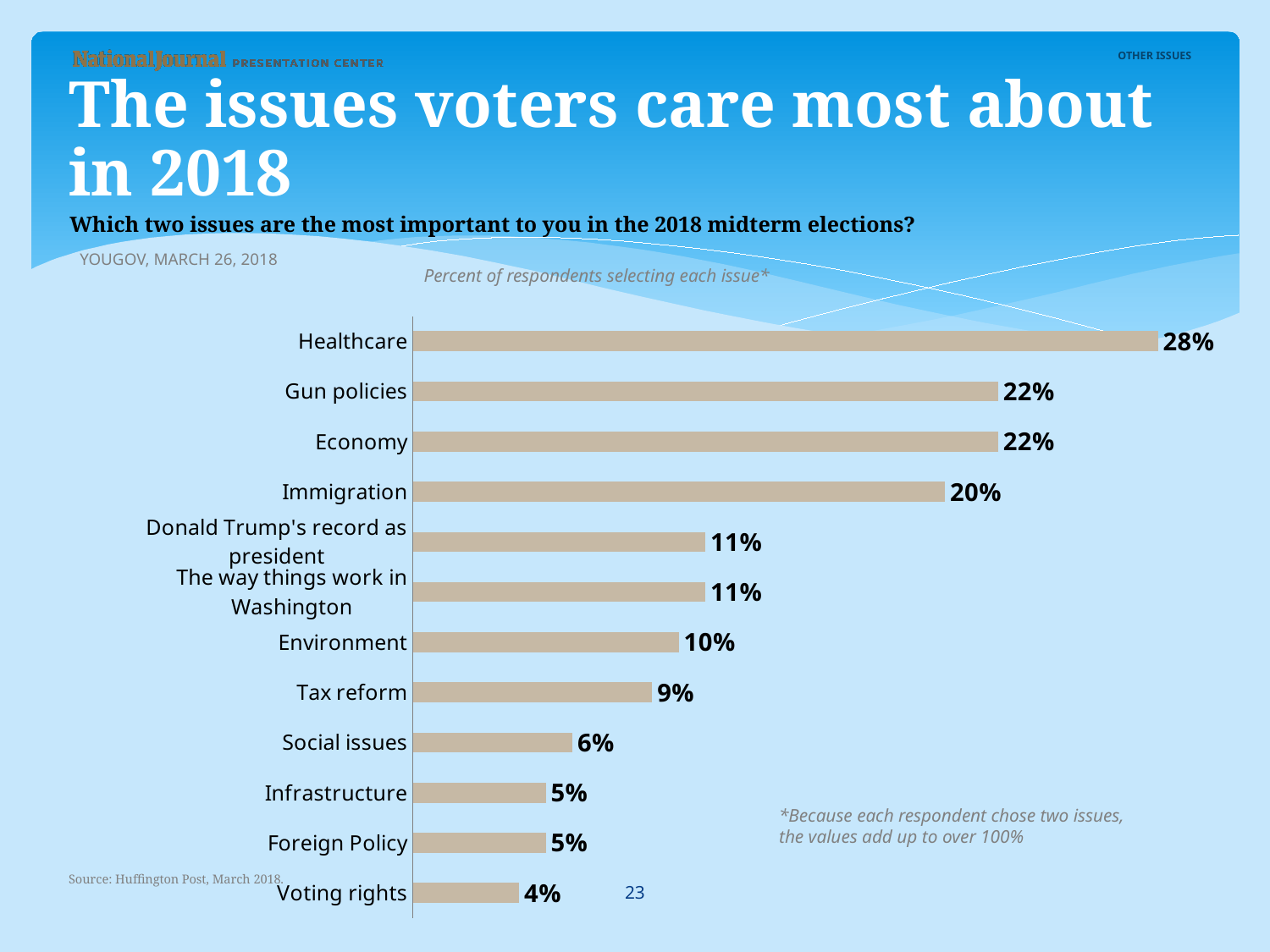
What percent of respondents selected Healthcare? 28% What kind of chart is shown on the slide? Bar chart What is the difference in percentage points between Immigration and Tax reform? 11 Which issue was selected by the lowest percent of respondents? Voting rights What percent of respondents selected Voting rights? 4% Which issue was selected by the highest percent of respondents? Healthcare How many issues are shown in the chart? 12 What percent of respondents selected Immigration? 20% What is the difference in percentage points between Healthcare and Gun policies? 6 What percent of respondents selected Environment? 10% Which was selected by more respondents, Economy or Environment? Economy What is the subtitle describing what the chart measures? Percent of respondents selecting each issue*